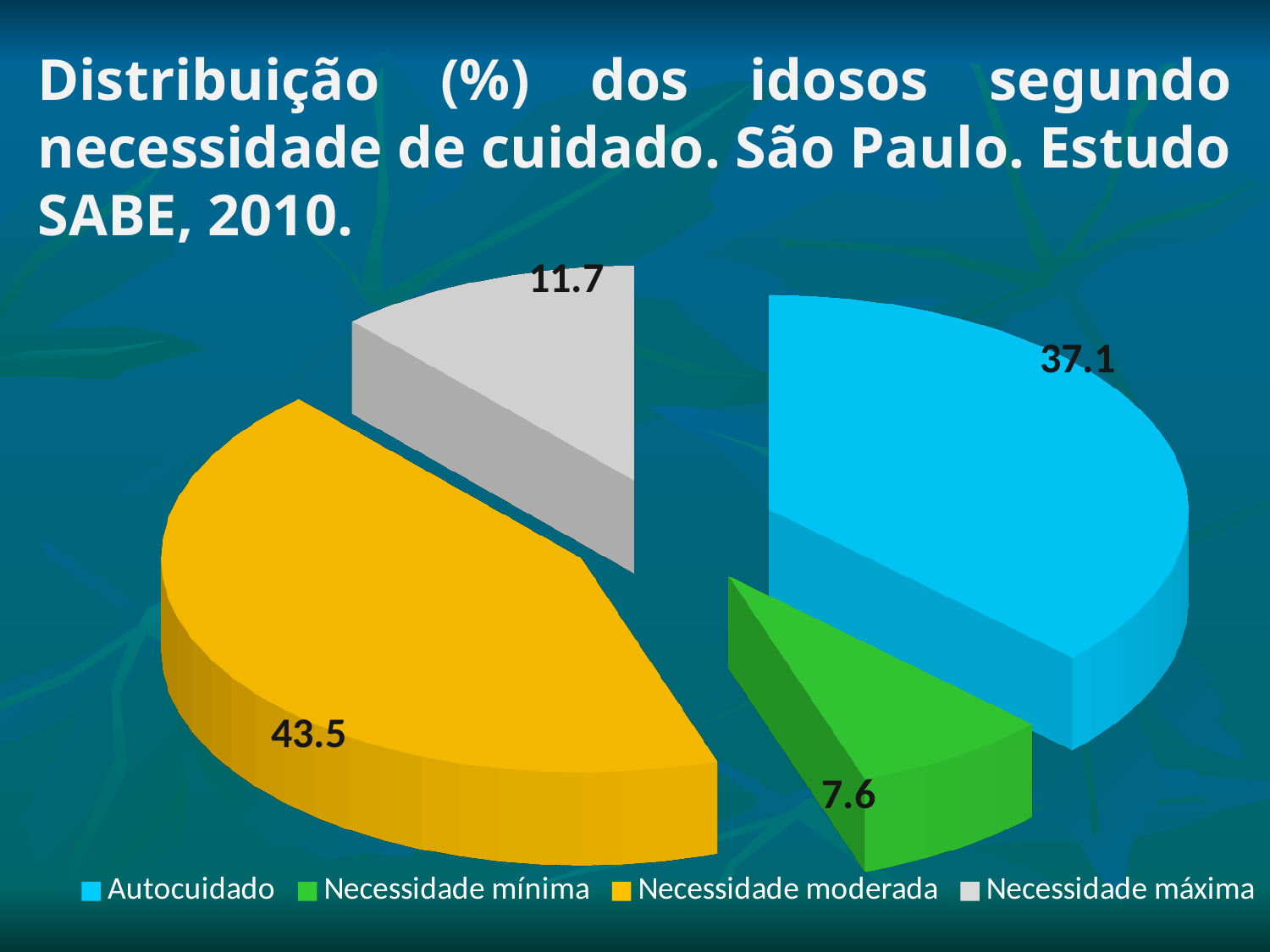
What kind of chart is shown on the slide? pie chart What is the value for Necessidade moderada? 43.5 Which category has the largest slice? Necessidade moderada What is the difference between the values for Necessidade máxima and Necessidade mínima? 4.1 What is the difference between the values for Necessidade moderada and Autocuidado? 6.4 What is the value for Necessidade mínima? 7.6 What is the value for Necessidade máxima? 11.7 What is the value for Autocuidado? 37.1 Which colour represents Necessidade mínima in the legend? green How many slices does the pie chart have? 4 Which is larger, the value for Autocuidado or the value for Necessidade máxima? Autocuidado Which category has the smallest slice? Necessidade mínima